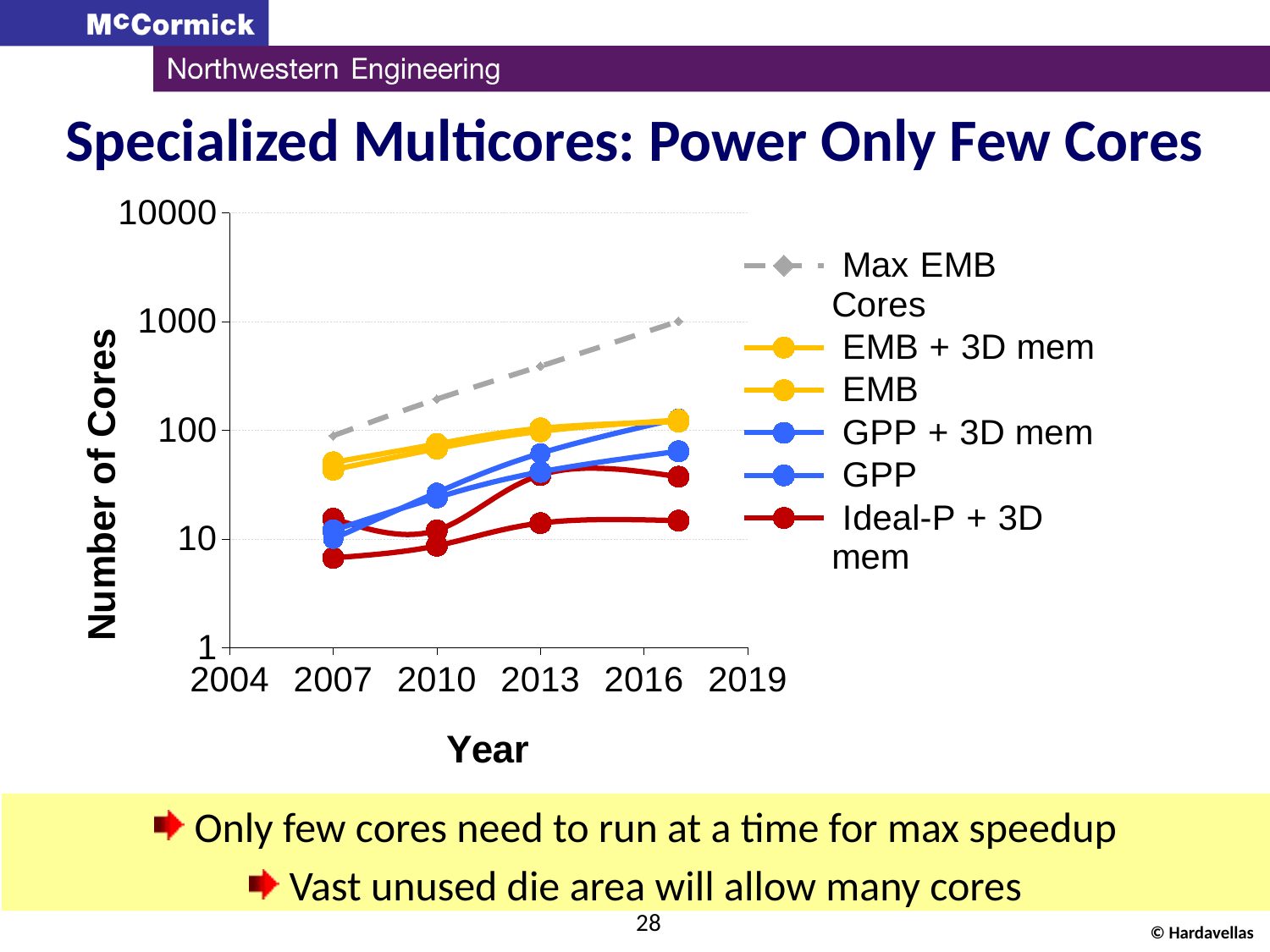
Is the value for Max EMB Cores in 2010 greater or less than 100? greater Is the value for Max EMB Cores in 2013 greater or less than 100? greater How many data points does the Max EMB Cores series have? 4 In 2013, which is larger: the value for EMB or the value for GPP? EMB Which series has the highest values across the chart? Max EMB Cores What kind of chart is shown on the slide? line chart Do the values for Max EMB Cores rise or fall as the year increases? rise What is the label of the x axis? Year How many series does the legend list? 6 What is the label of the y axis? Number of Cores